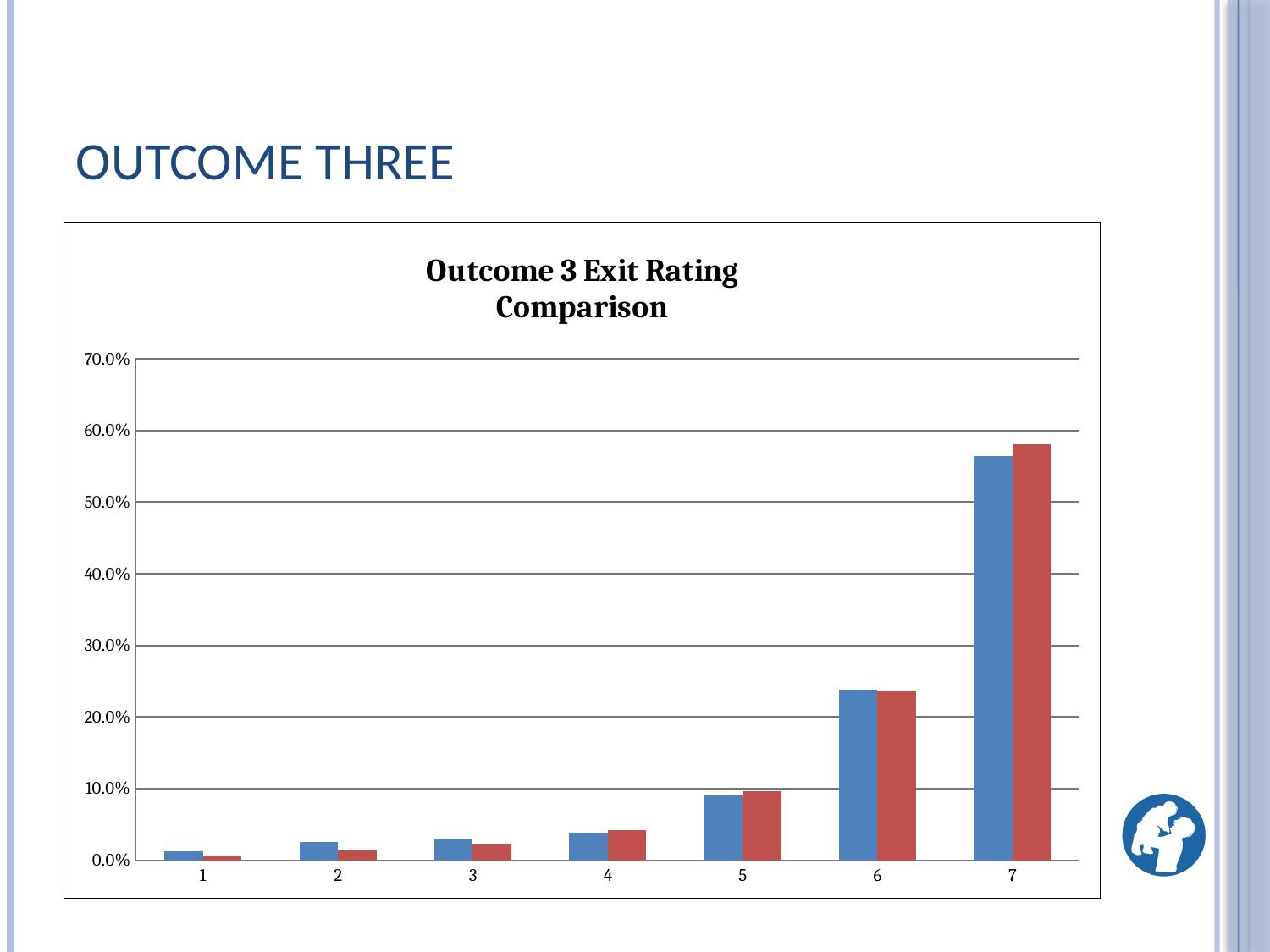
What kind of chart is shown on the slide? bar chart How many bars are plotted for each category? 2 Which category has the lowest value for the red bars? 1 What is the title of the chart? Outcome 3 Exit Rating Comparison How many categories are shown on the x axis? 7 For category 7, which bar is taller, the blue one or the red one? red Is the value of the blue bar for category 7 greater or less than 50.0%? greater Do the values generally rise or fall from category 1 to category 7? rise Which category has the highest value for the blue bars? 7 Is the value of the red bar for category 6 greater or less than 20.0%? greater For category 1, which bar is taller, the blue one or the red one? blue Is the value of the blue bar for category 5 greater or less than 10.0%? less